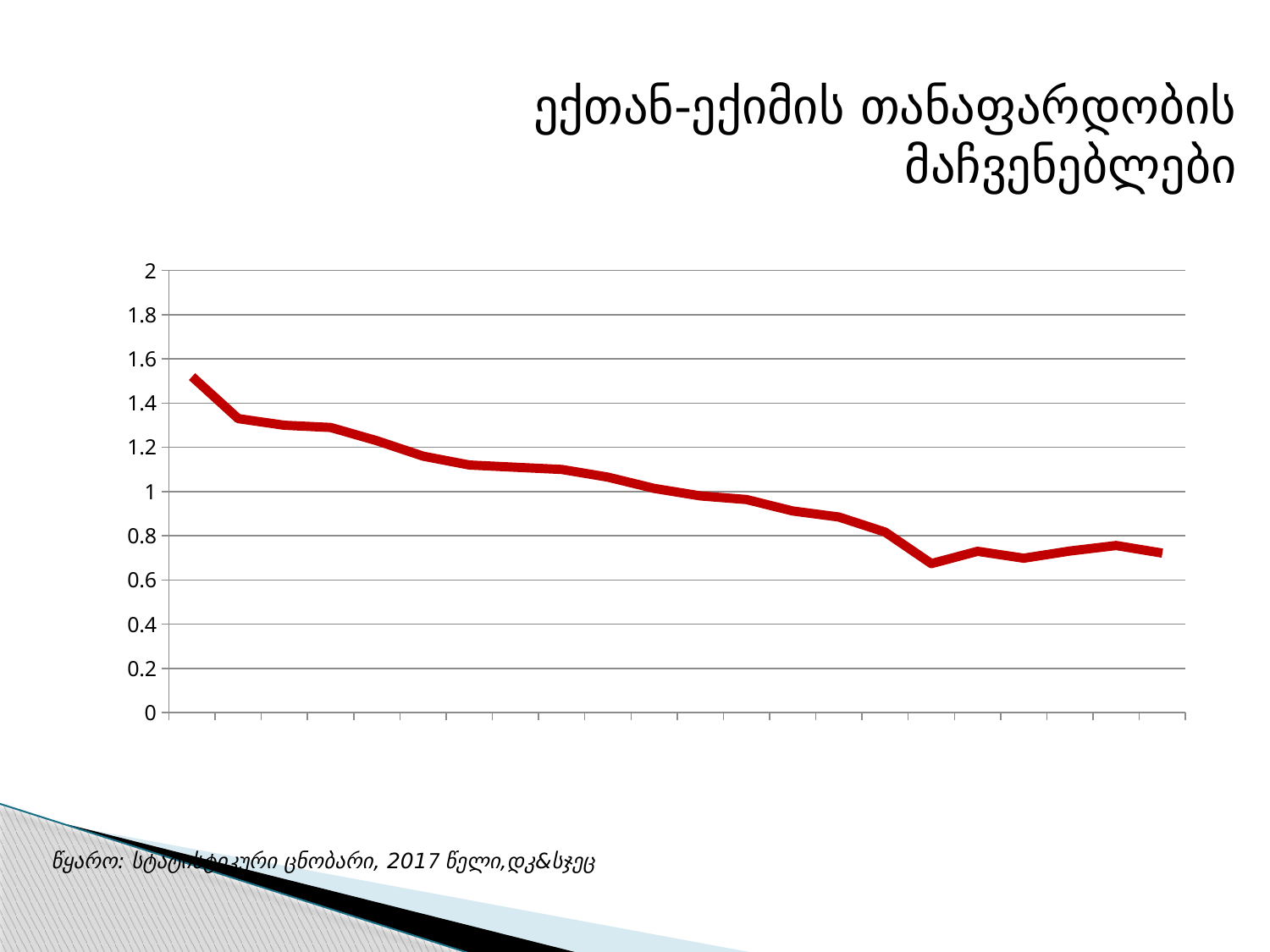
What colour is the plotted line? dark red How many lines (series) are plotted on the chart? 1 Is the value of the last (rightmost) point greater or less than 0.8? less Which point on the line has the highest value, the leftmost or the rightmost? the leftmost What kind of chart is shown on the slide? line chart Is the first point of the line higher or lower than the last point? higher Do the values generally rise or fall from left to right along the x axis? fall Is the lowest point on the line greater or less than 0.6? greater Is the value of the first (leftmost) point greater or less than 1.4? greater What is the maximum value shown on the vertical axis? 2